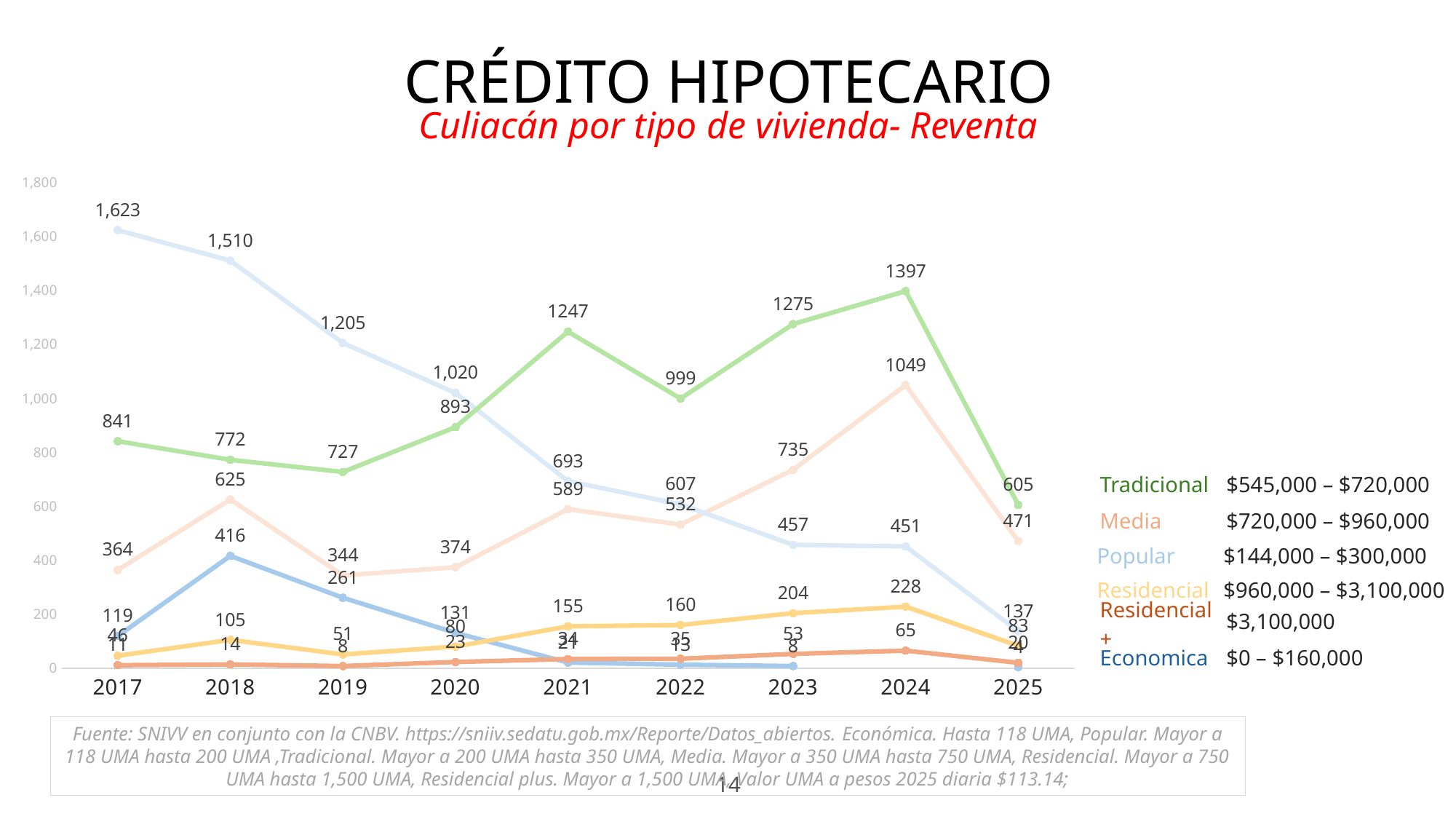
What is the value for Popular in 2017? 1,623 What is the value for Media in 2024? 1049 What is the value for Economica in 2018? 416 How many series does the legend list? 6 What kind of chart is shown on the slide? Line chart What is the value for Residencial in 2024? 228 What is the value for Tradicional in 2024? 1397 In which year is the Popular series at its lowest value? 2025 What is the difference between the Tradicional values for 2024 and 2025? 792 How many years are shown on the x axis? 9 Which is larger in 2021, Tradicional or Media? Tradicional In which year does the Tradicional series reach its highest value? 2024